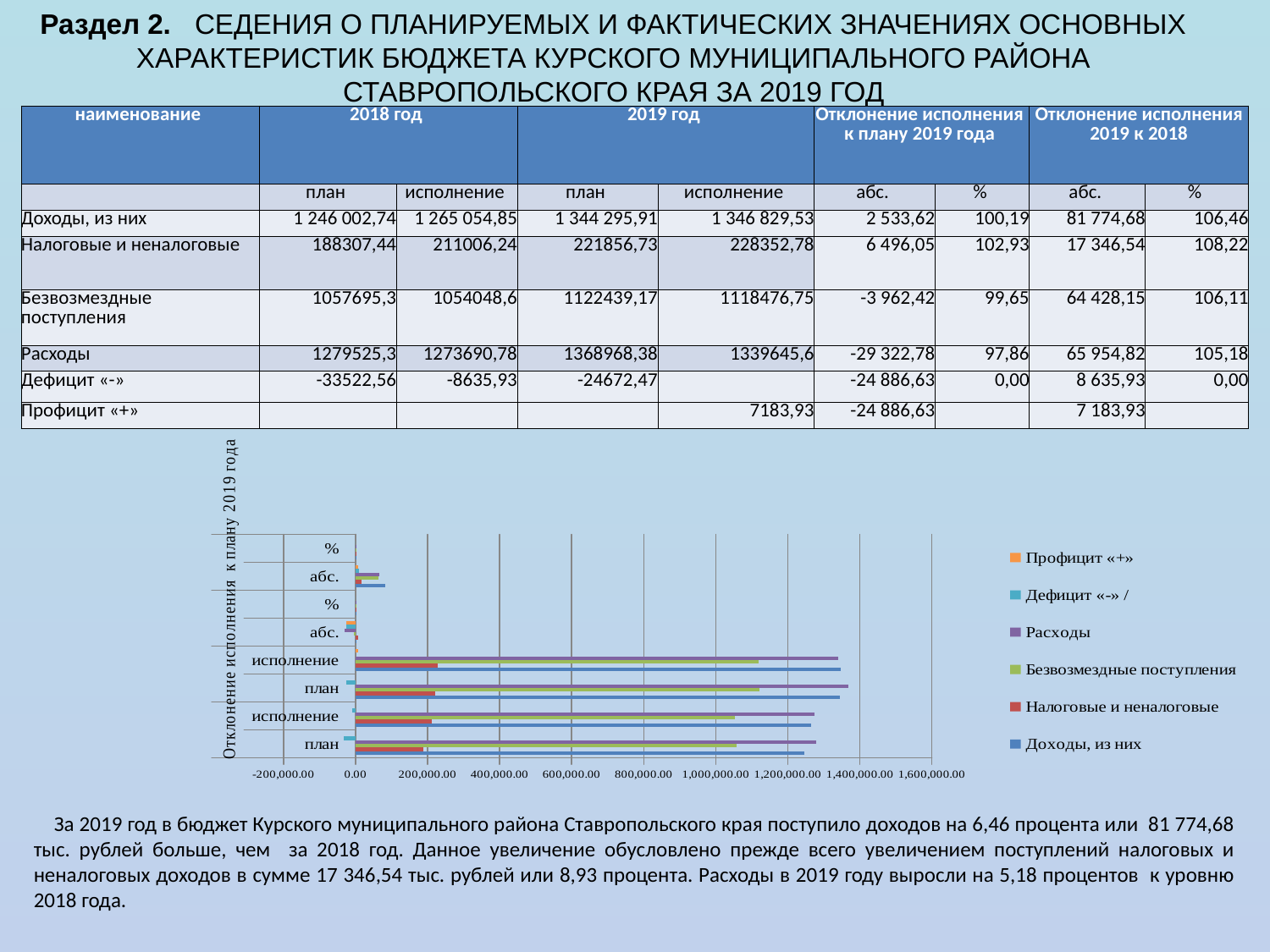
In the second 'план' category from the bottom, is the value for Расходы greater or less than 1,200,000.00? greater In the bottom 'план' category, is the value for Налоговые и неналоговые greater or less than 400,000.00? less In the bottom 'план' category, is the value for Доходы, из них greater or less than 1,000,000.00? greater In the second 'план' category from the bottom, which is larger: Доходы, из них or Безвозмездные поступления? Доходы, из них In the bottom 'исполнение' category, which is larger: Расходы or Налоговые и неналоговые? Расходы What is the highest value shown on the chart's horizontal axis? 1,600,000.00 How many series does the chart legend list? 6 How many categories are shown on the vertical axis of the chart? 8 What kind of chart is shown on the slide? bar chart Which series is listed first (at the top) in the chart legend? Профицит «+»